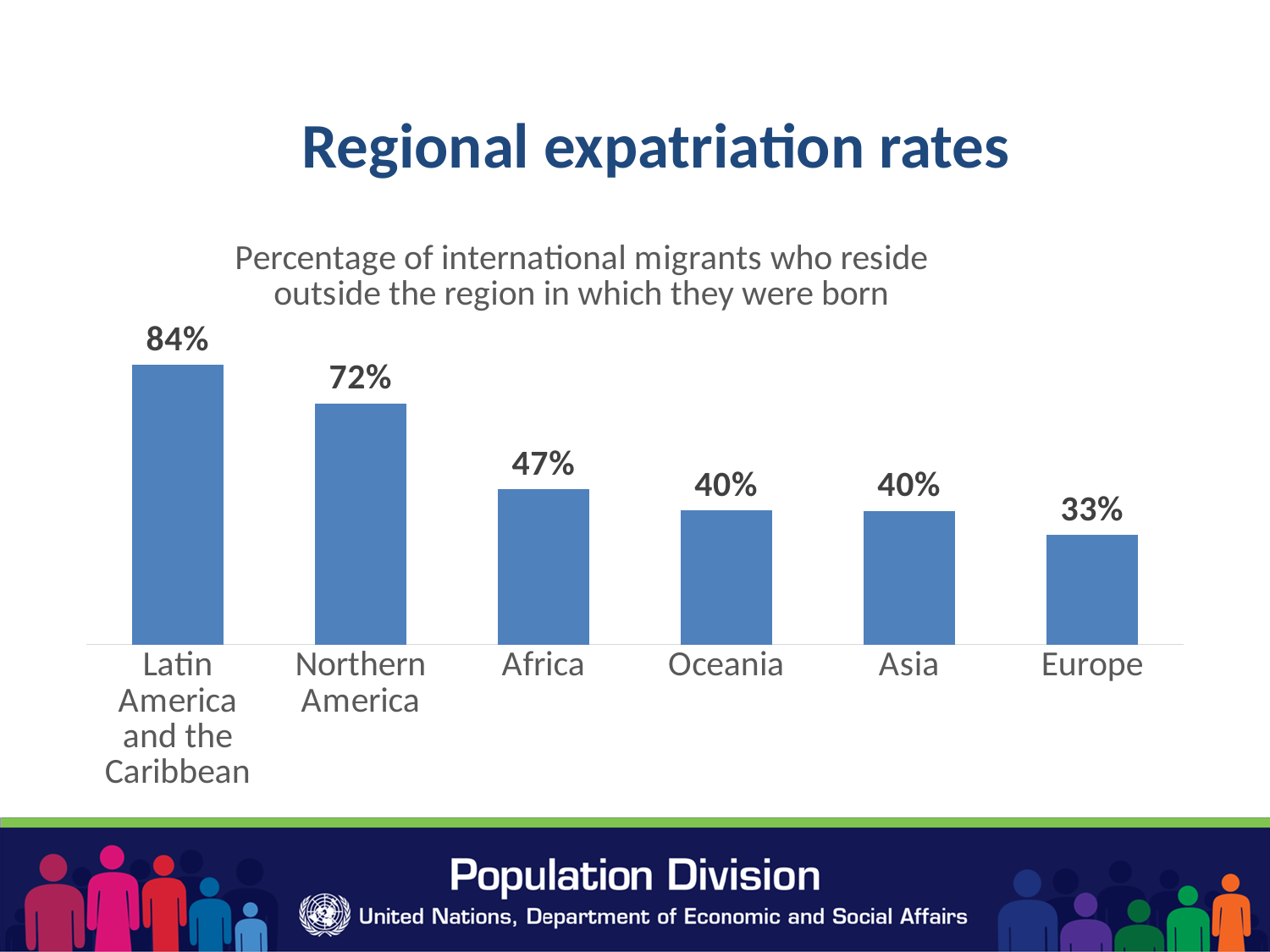
What is the expatriation rate for Africa? 47% What is the difference between the expatriation rates of Latin America and the Caribbean and Northern America? 12% Which region has the highest expatriation rate? Latin America and the Caribbean What is the subtitle of the chart? Percentage of international migrants who reside outside the region in which they were born How many regions are shown in the chart? 6 What is the expatriation rate for Latin America and the Caribbean? 84% What is the expatriation rate for Europe? 33% What is the expatriation rate for Northern America? 72% What is the difference between the expatriation rates of Africa and Europe? 14% Which has a higher expatriation rate, Northern America or Africa? Northern America What type of chart is shown on the slide? Bar chart Which region has the lowest expatriation rate? Europe